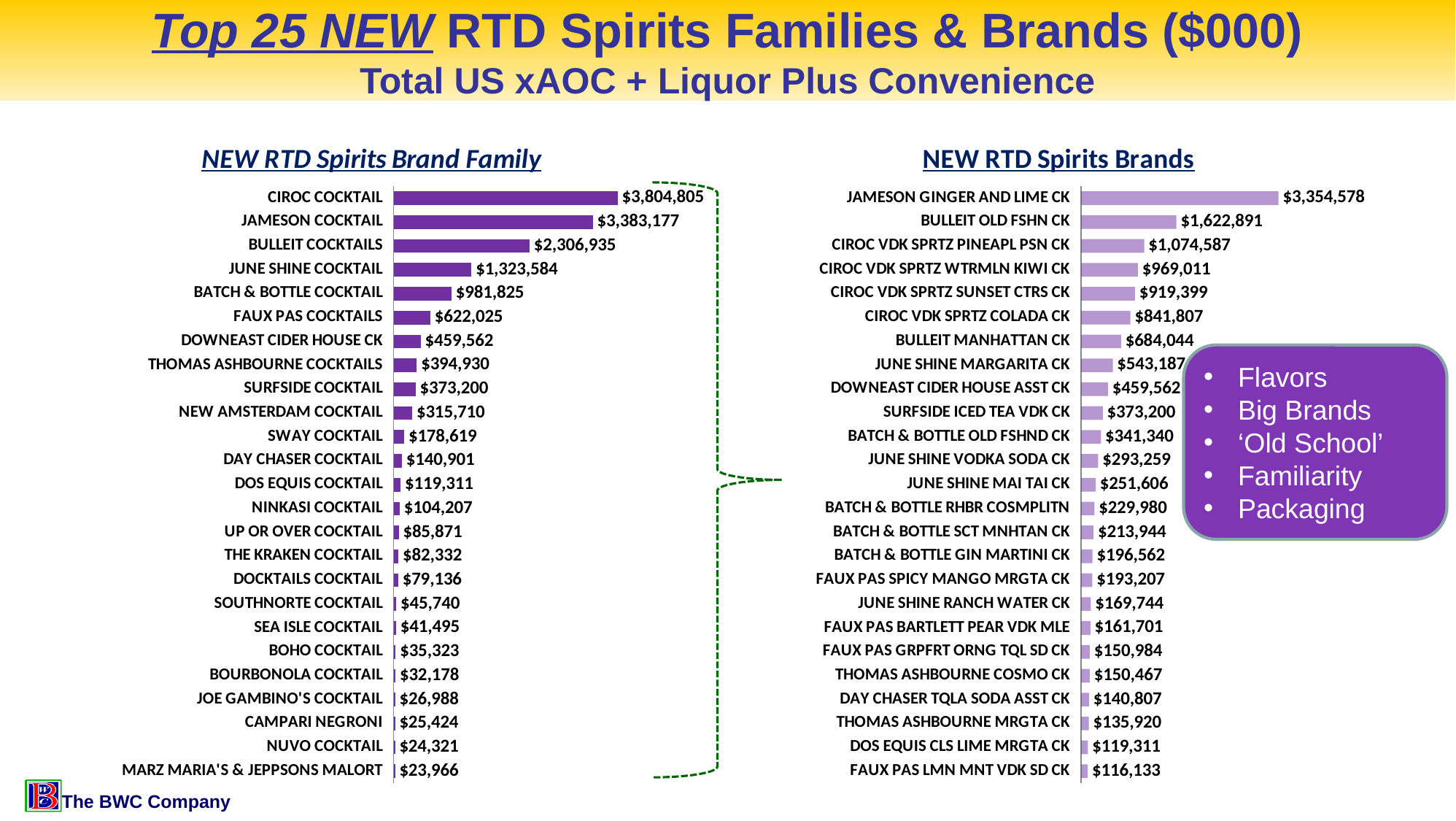
How many brands are shown in the NEW RTD Spirits Brands chart? 25 In the NEW RTD Spirits Brands chart, what is the value for BULLEIT MANHATTAN CK? $684,044 In the NEW RTD Spirits Brand Family chart, what is the difference between CIROC COCKTAIL and JAMESON COCKTAIL? $421,628 In the NEW RTD Spirits Brand Family chart, which is larger: BATCH & BOTTLE COCKTAIL or FAUX PAS COCKTAILS? BATCH & BOTTLE COCKTAIL In the NEW RTD Spirits Brands chart, which is larger: CIROC VDK SPRTZ COLADA CK or JUNE SHINE MARGARITA CK? CIROC VDK SPRTZ COLADA CK In the NEW RTD Spirits Brand Family chart, what is the value for JUNE SHINE COCKTAIL? $1,323,584 In the NEW RTD Spirits Brand Family chart, what is the value for MARZ MARIA'S & JEPPSONS MALORT? $23,966 In the NEW RTD Spirits Brands chart, which brand has the lowest value? FAUX PAS LMN MNT VDK SD CK How many brand families are shown in the NEW RTD Spirits Brand Family chart? 25 What type of chart is the NEW RTD Spirits Brands chart? Bar chart In the NEW RTD Spirits Brands chart, what is the difference between JAMESON GINGER AND LIME CK and BULLEIT OLD FSHN CK? $1,731,687 In the NEW RTD Spirits Brand Family chart, which brand family has the highest value? CIROC COCKTAIL